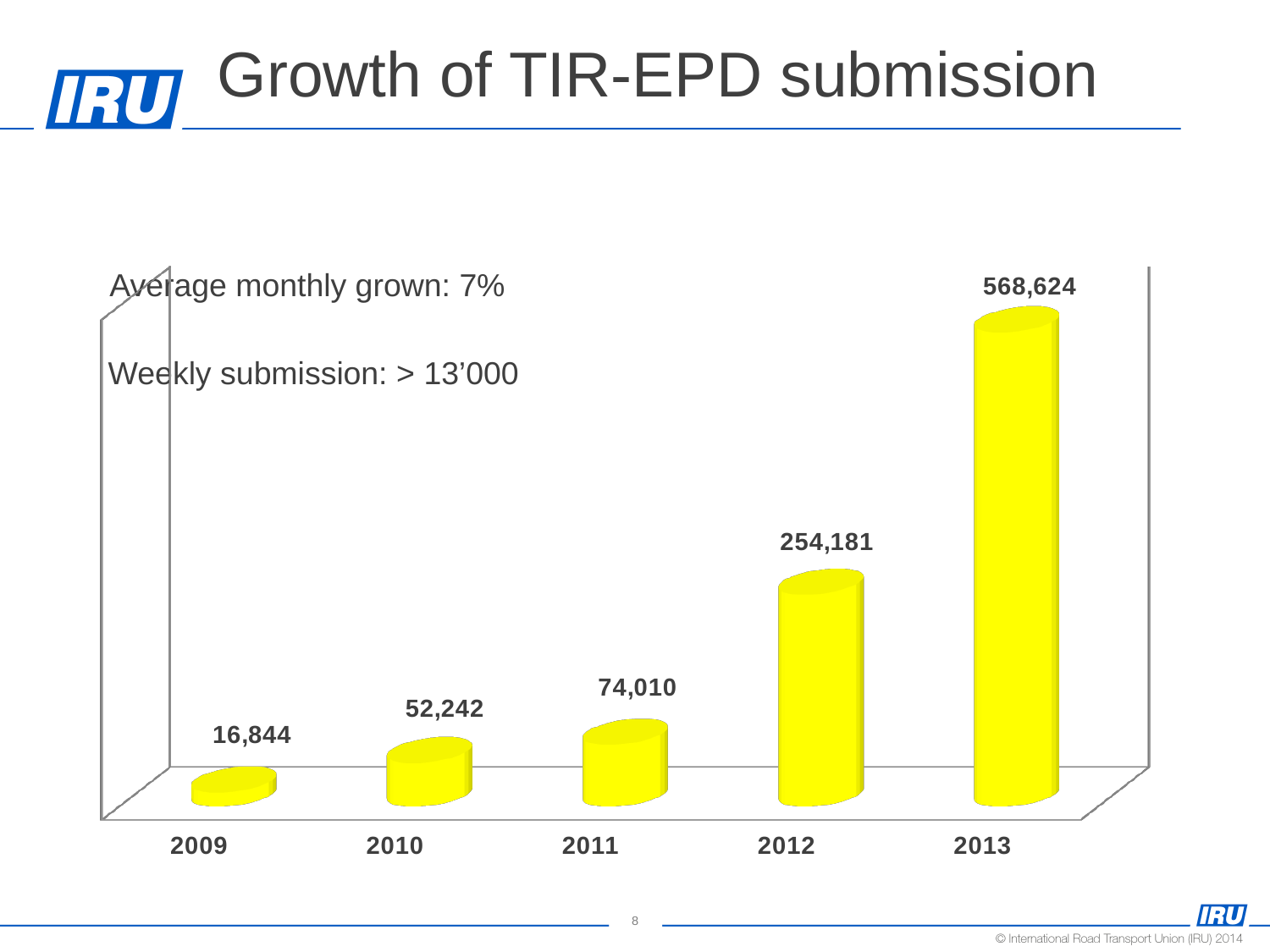
What is the value for 2011? 74,010 What is the difference between the values for 2013 and 2012? 314,443 Which is larger, the value for 2011 or the value for 2010? 2011 Do the values rise or fall from 2009 to 2013? rise Which year has the lowest value? 2009 What is the difference between the values for 2010 and 2009? 35,398 What is the value for 2009? 16,844 What is the title of the slide containing the chart? Growth of TIR-EPD submission What kind of chart is shown on the slide? bar chart Which year has the highest value? 2013 How many years are shown on the x axis? 5 What is the value for 2013? 568,624